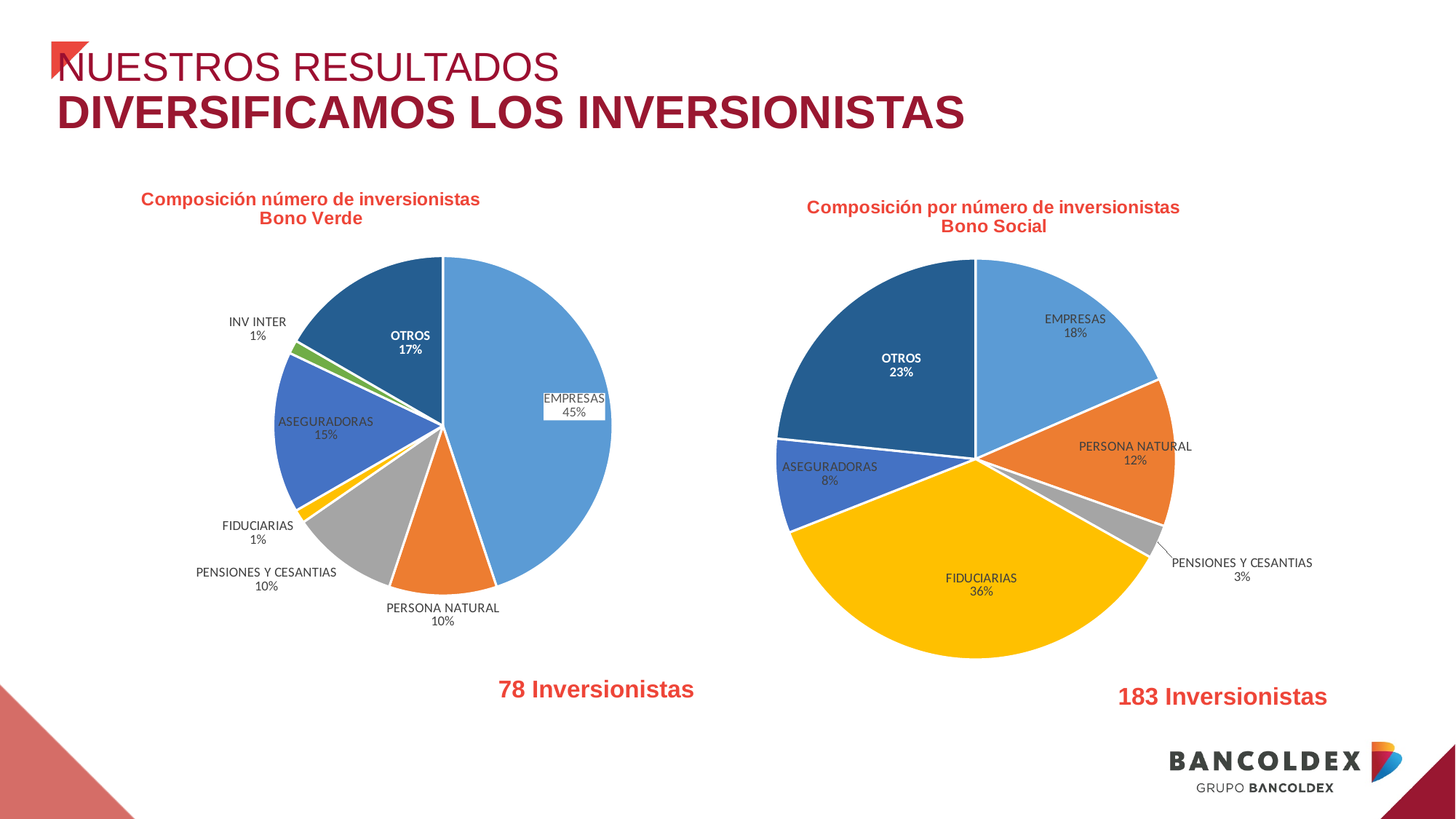
In the Bono Verde pie chart, what is the difference between the shares of EMPRESAS and OTROS? 28 percentage points What type of chart is used for the Bono Social composition? Pie chart In the Bono Social pie chart, which category has the smallest share? PENSIONES Y CESANTIAS In the Bono Social pie chart, which category has the largest share? FIDUCIARIAS In the Bono Social pie chart, which is larger: the share of EMPRESAS or the share of PERSONA NATURAL? EMPRESAS In the Bono Social pie chart, what share do ASEGURADORAS hold? 8% In the Bono Verde pie chart, which category has the largest share? EMPRESAS How many categories are shown in the Bono Verde pie chart? 7 In the Bono Social pie chart, what share do FIDUCIARIAS hold? 36% How many categories are shown in the Bono Social pie chart? 6 In the Bono Verde pie chart, what share do EMPRESAS hold? 45% How many investors does the Bono Social chart represent, according to the text below it? 183 Inversionistas